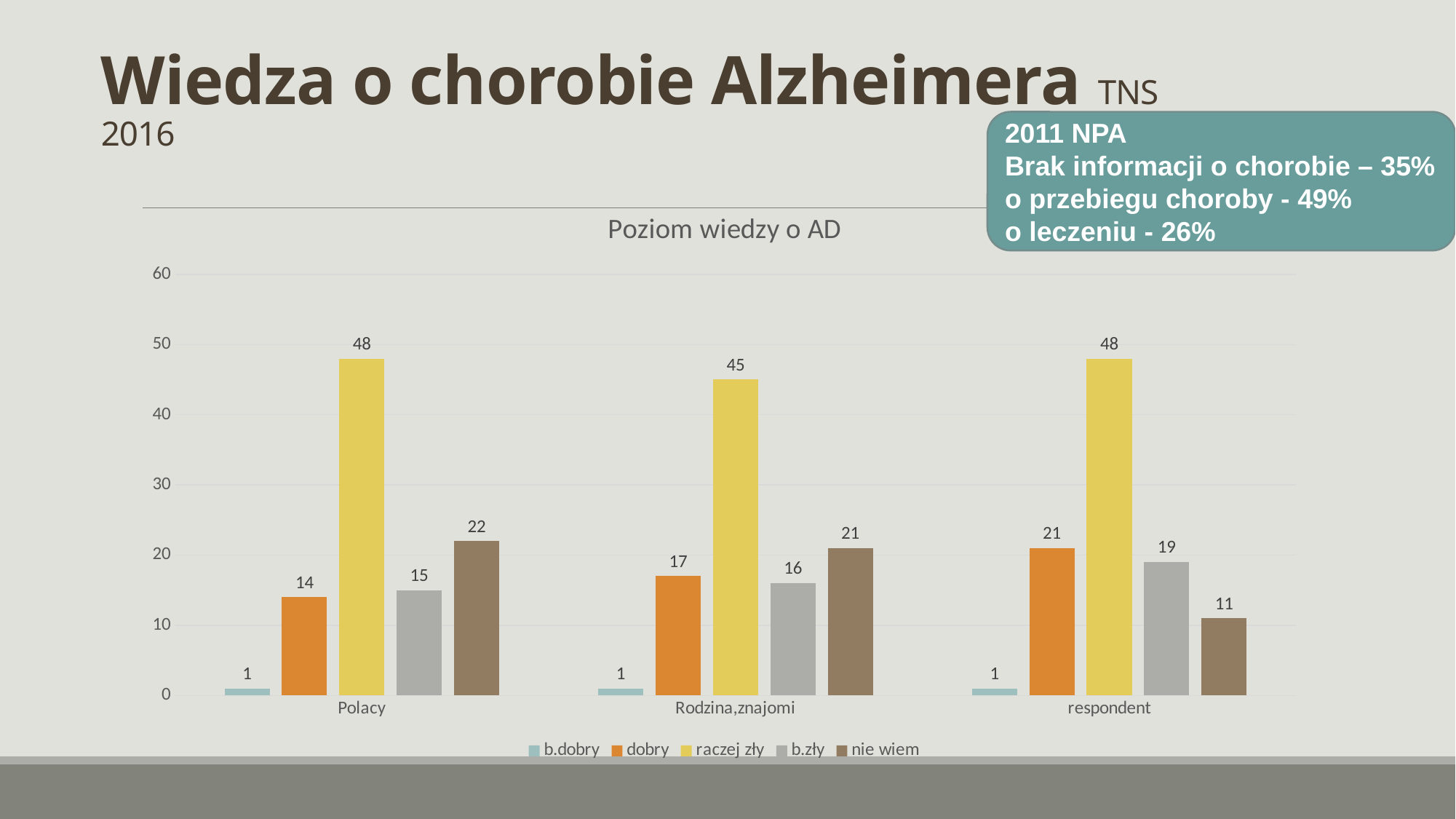
What is the value for "nie wiem" in the Rodzina,znajomi category? 21 What is the value for "raczej zły" in the Polacy category? 48 What is the difference between "nie wiem" for Polacy and "nie wiem" for respondent? 11 Which series has the lowest value in the respondent category? b.dobry What kind of chart is shown on the slide? bar chart What is the value for "dobry" in the respondent category? 21 What is the title of the chart? Poziom wiedzy o AD How many series does the legend list? 5 How many categories are shown on the x axis? 3 Which series has the highest value in the Rodzina,znajomi category? raczej zły Which colour represents the "dobry" series in the legend? orange Which is larger: "b.zły" for Polacy or "b.zły" for respondent? b.zły for respondent